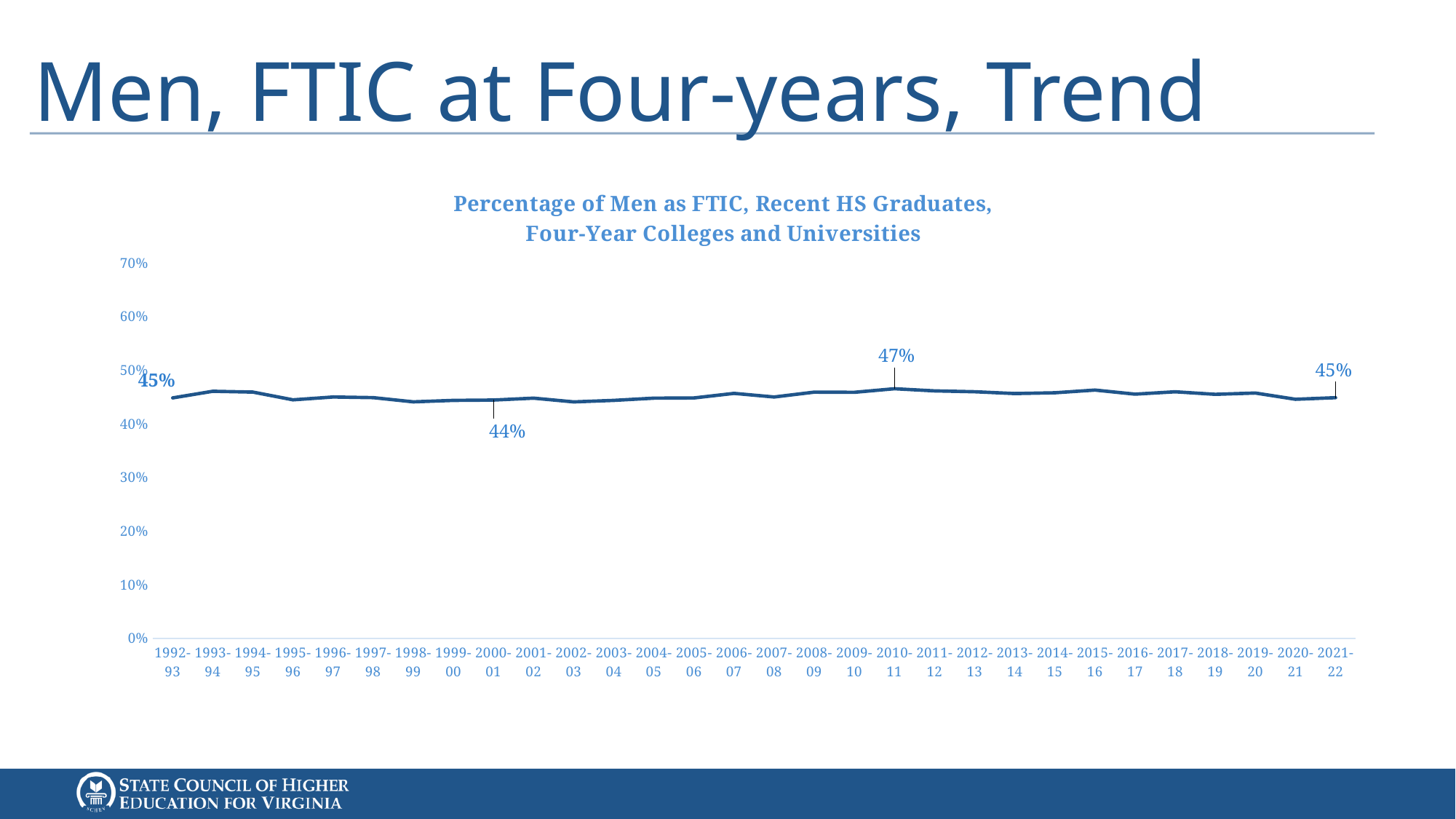
What is the chart's title? Percentage of Men as FTIC, Recent HS Graduates, Four-Year Colleges and Universities Is the value for 2005-06 greater or less than 60%? less What is the value for 2000-01? 44% What is the value for 2010-11? 47% What is the value for 2021-22? 45% How many academic years are plotted on the x axis? 30 Is the value for 2015-16 greater or less than 30%? greater What is the value for 1992-93? 45% What is the highest value shown on the y axis? 70% Which is larger, the value for 2010-11 or the value for 2000-01? 2010-11 What type of chart is shown on the slide? line chart What is the difference between the value for 2010-11 and the value for 2000-01? 3%